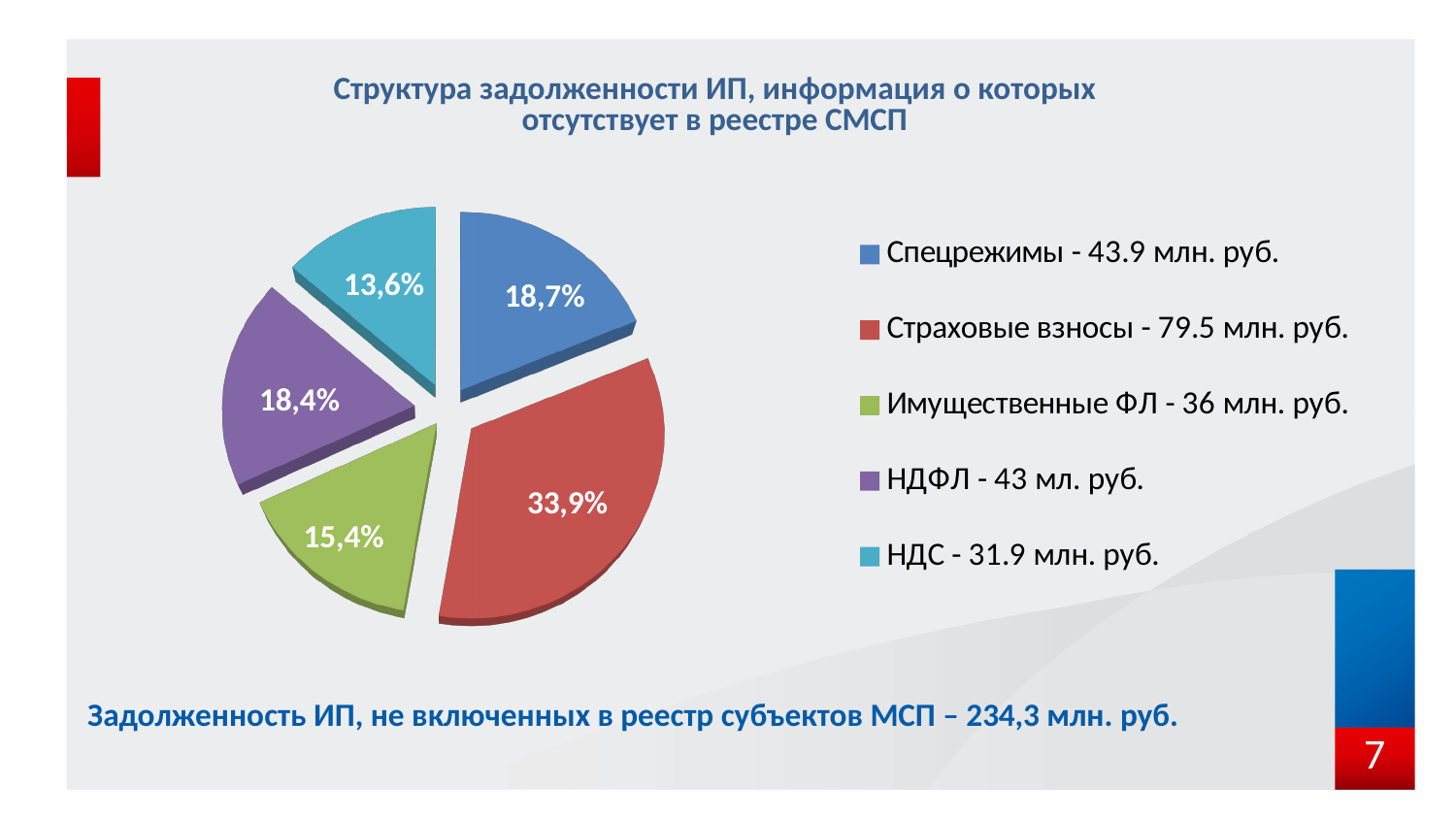
How many slices does the pie chart have? 5 According to the legend, what is the amount for Имущественные ФЛ? 36 млн. руб. What share of the pie does Страховые взносы account for? 33,9% What share of the pie does НДС account for? 13,6% What share of the pie does НДФЛ account for? 18,4% Which category has the largest slice of the pie? Страховые взносы Which category has the smallest slice of the pie? НДС What colour is the Страховые взносы slice? Red Which slice is larger, Спецрежимы or НДФЛ? Спецрежимы What kind of chart is shown on the slide? Pie chart What is the title of the chart? Структура задолженности ИП, информация о которых отсутствует в реестре СМСП What is the difference in percentage points between the Страховые взносы slice and the Имущественные ФЛ slice? 18,5 percentage points